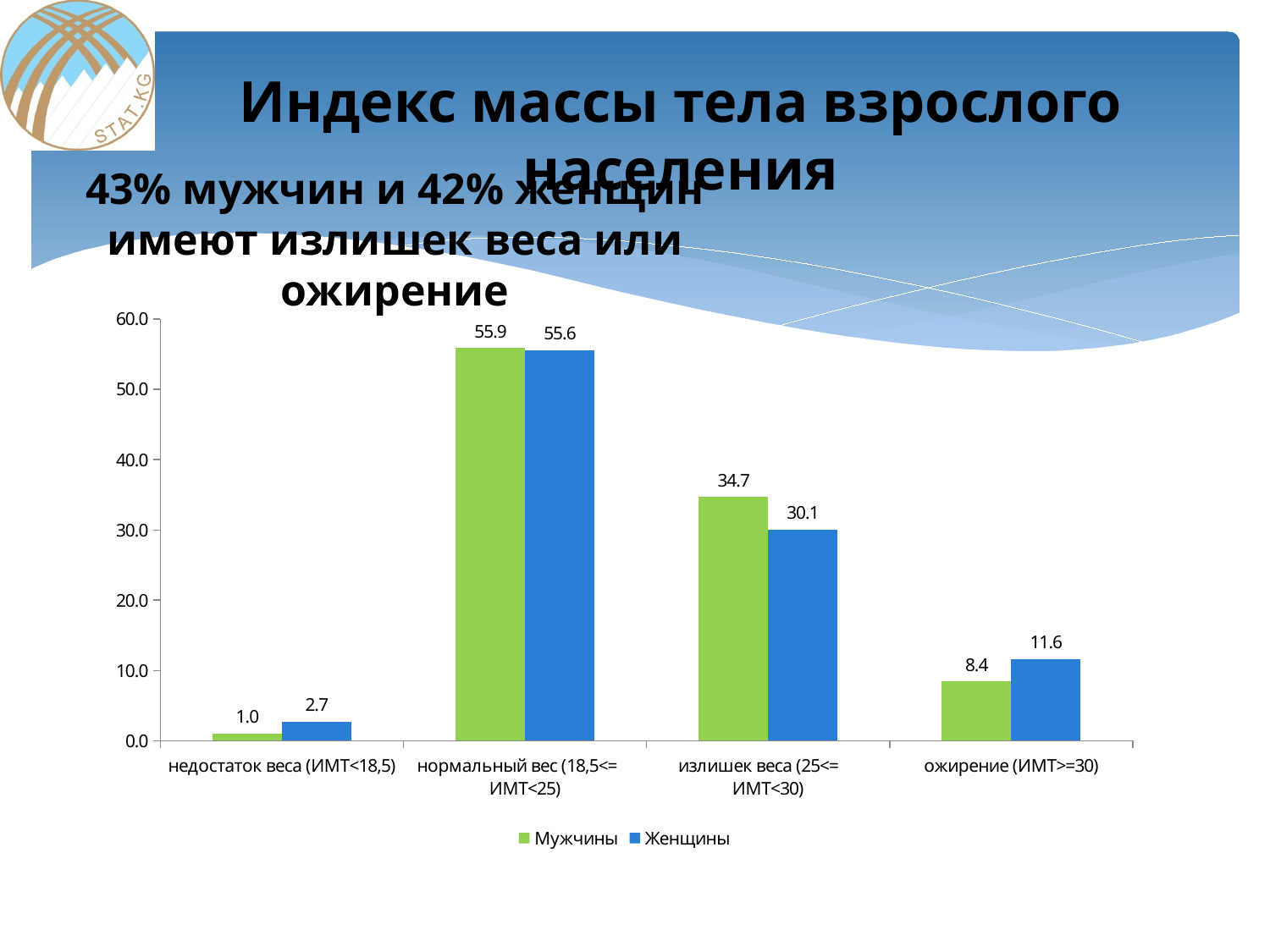
Which category has the lowest value for Женщины? недостаток веса (ИМТ<18,5) How many series does the legend list? 2 How many categories are shown on the x axis? 4 What is the value for Мужчины in the category недостаток веса (ИМТ<18,5)? 1.0 What is the difference between Мужчины and Женщины in the category излишек веса (25<= ИМТ<30)? 4.6 What is the value for Женщины in the category ожирение (ИМТ>=30)? 11.6 What is the value for Женщины in the category излишек веса (25<= ИМТ<30)? 30.1 What is the value for Мужчины in the category нормальный вес (18,5<= ИМТ<25)? 55.9 Is the value for Мужчины in the category излишек веса (25<= ИМТ<30) greater or less than 30.0? greater Which category has the highest value for Мужчины? нормальный вес (18,5<= ИМТ<25) In the category ожирение (ИМТ>=30), which series has the larger value, Мужчины or Женщины? Женщины What kind of chart is shown on the slide? bar chart